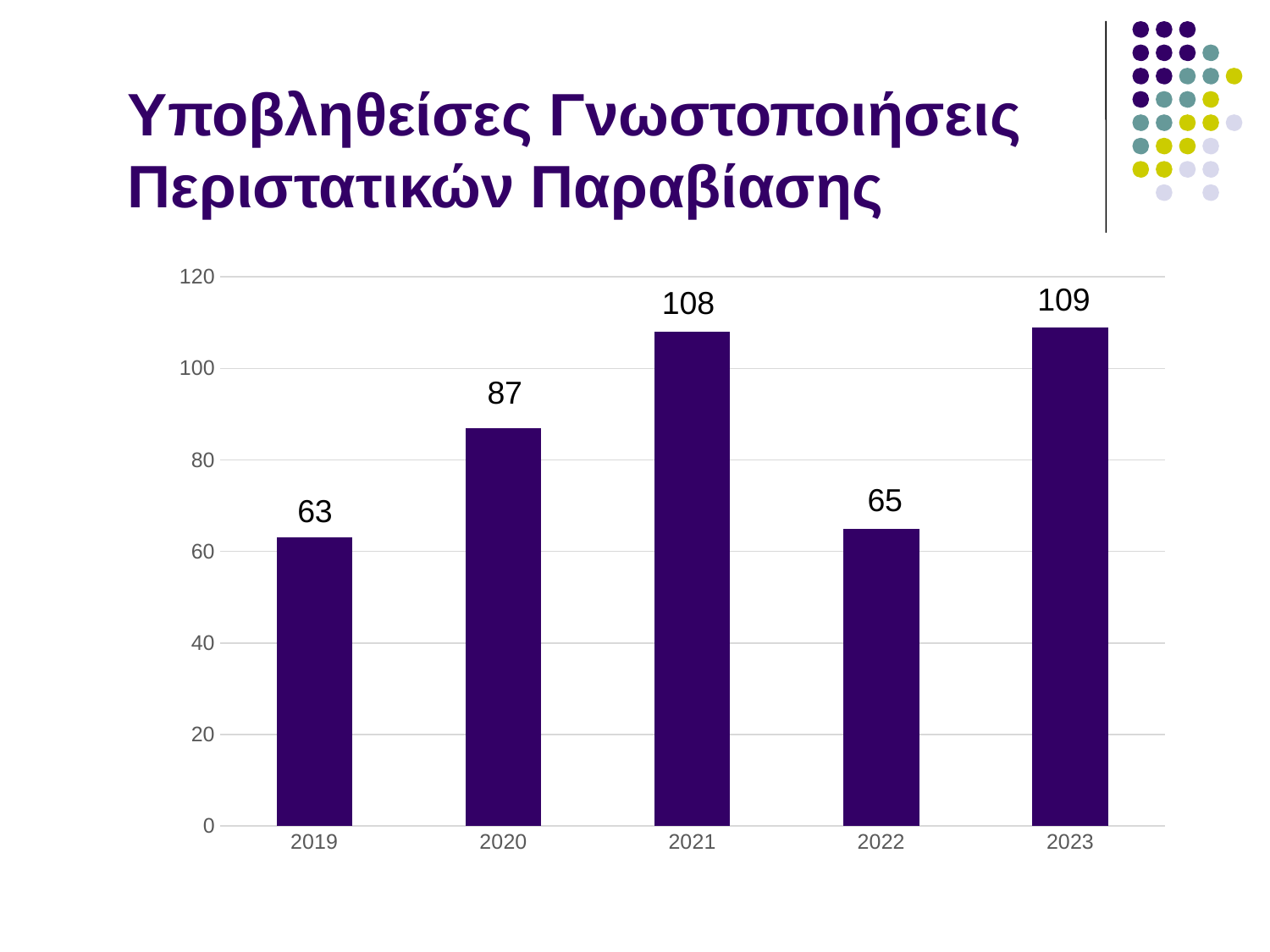
What is the difference between the values for 2021 and 2020? 21 What is the value for 2019? 63 What is the value for 2022? 65 What is the title of the slide? Υποβληθείσες Γνωστοποιήσεις Περιστατικών Παραβίασης Which year has the lowest value? 2019 What is the value for 2021? 108 Which year has the highest value? 2023 What kind of chart is shown on the slide? bar chart Is the value for 2020 greater or less than 80? greater What is the difference between the values for 2023 and 2022? 44 Which is larger, the value for 2020 or the value for 2022? 2020 How many years are shown on the x axis? 5